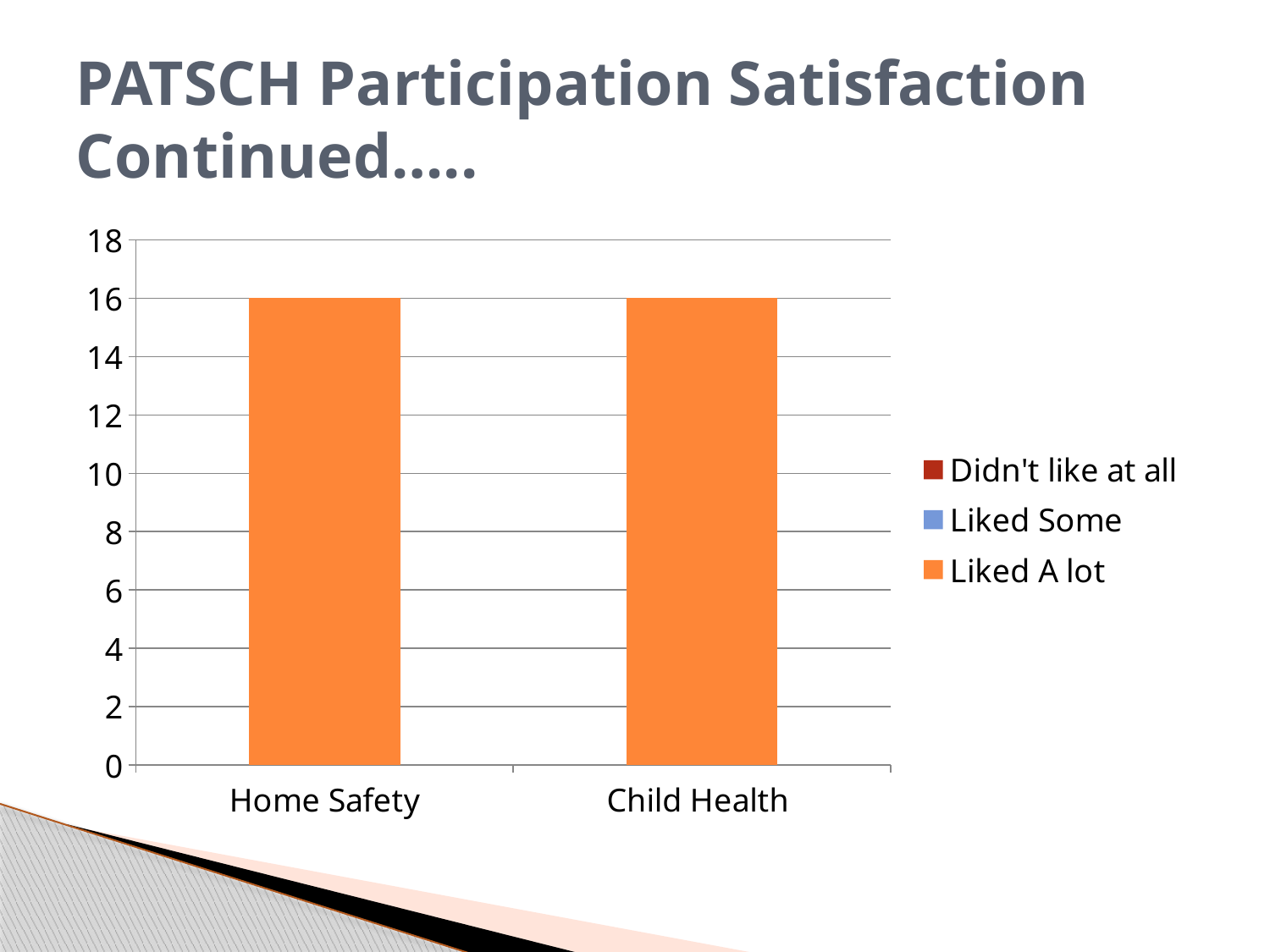
What is the difference between the 'Liked A lot' values for Home Safety and Child Health? 0 Is the 'Liked A lot' value for Child Health greater or less than 18? less How many categories are shown on the x axis of the chart? 2 Is the 'Liked A lot' value for Home Safety greater or less than 10? greater Which series in the legend is shown in orange? Liked A lot What kind of chart is shown on the slide? bar chart What is the 'Liked A lot' value for Child Health? 16 What is the 'Liked A lot' value for Home Safety? 16 Which two categories are labelled on the x axis of the chart? Home Safety and Child Health How many series does the chart's legend list? 3 What is the highest value shown on the chart's vertical axis? 18